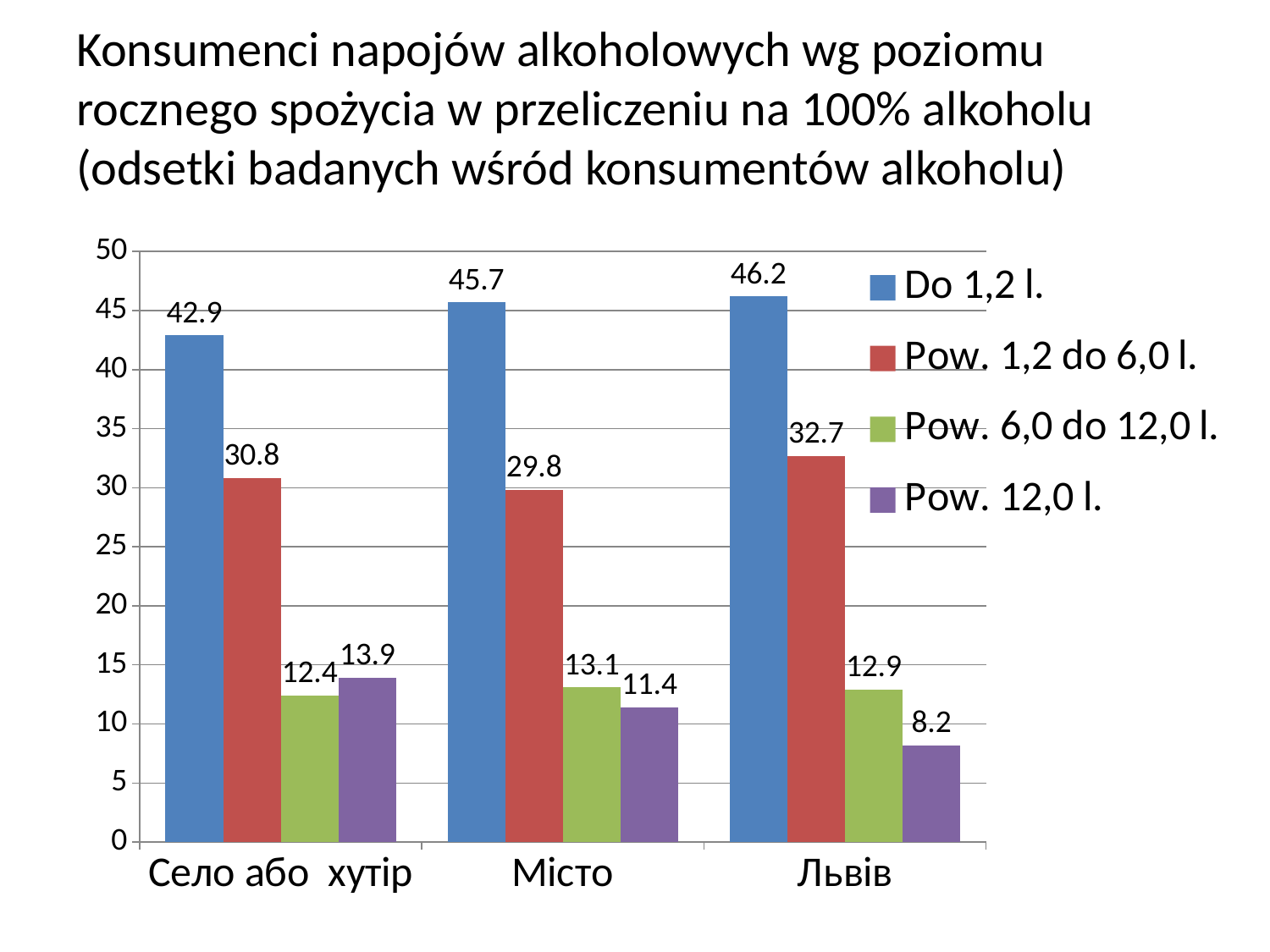
Which category has the highest value for the 'Do 1,2 l.' series? Львів Which is larger: the 'Pow. 12,0 l.' value for 'Село або хутір' or for 'Місто'? Село або хутір What is the difference between the 'Pow. 1,2 do 6,0 l.' values for 'Львів' and 'Місто'? 2.9 What colour are the bars for the 'Pow. 6,0 do 12,0 l.' series? green Which category has the lowest value for the 'Pow. 12,0 l.' series? Львів What kind of chart is shown on the slide? bar chart How many series does the legend list? 4 Is the value for 'Do 1,2 l.' in 'Село або хутір' greater or less than 40? greater How many categories are shown on the x axis? 3 What is the value for 'Pow. 6,0 do 12,0 l.' in the 'Село або хутір' category? 12.4 What is the value for 'Do 1,2 l.' in the 'Місто' category? 45.7 What is the value for 'Pow. 12,0 l.' in the 'Львів' category? 8.2